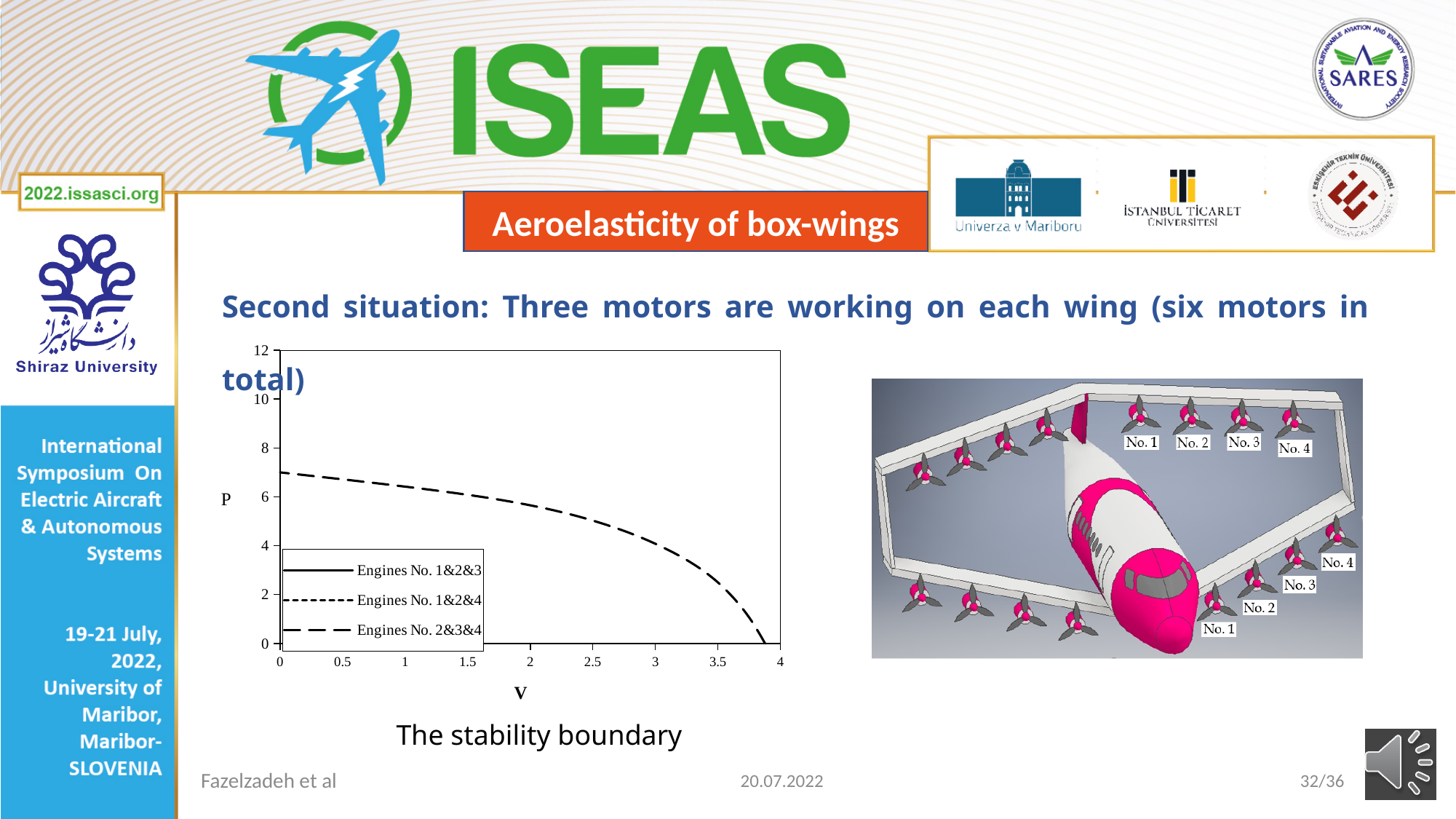
Does the plotted curve rise or fall as v increases along the x axis? fall What kind of chart is shown on the slide? line chart What is the highest tick value shown on the x axis of the chart? 4 Is the value of P at v = 3.5 greater or less than 4? less Is the value of P at v = 2.5 greater or less than 6? less What is the highest tick value shown on the y axis of the chart? 12 How many series does the chart's legend list? 3 Is the value of P at v = 2.5 greater or less than 4? greater What is the label on the vertical axis of the chart? P What is the caption written below the chart? The stability boundary